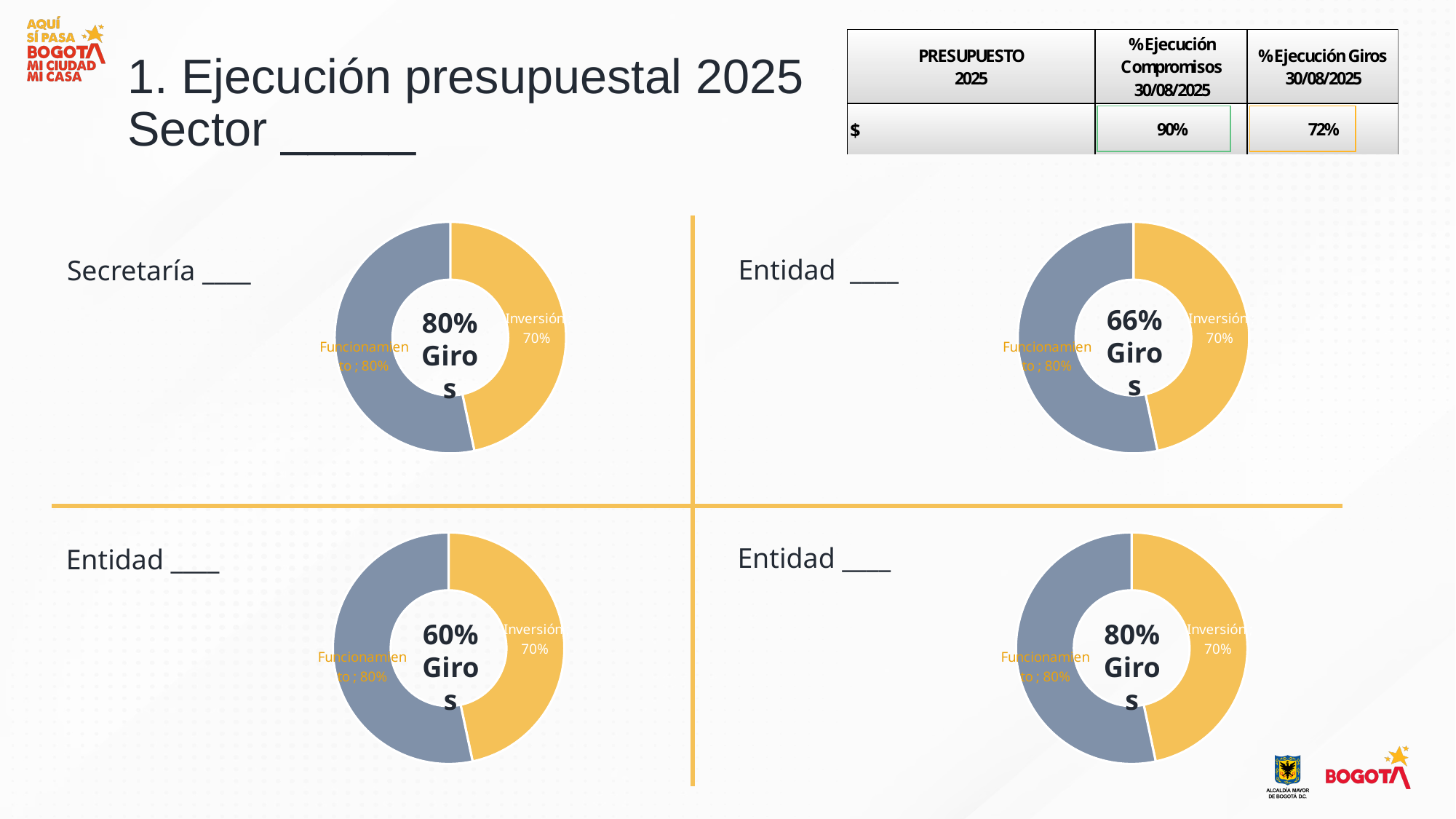
What kind of chart is used in each of the four quadrants of the slide? Donut (pie) chart What percentage of Giros is shown in the centre of the bottom-left donut chart? 60% Which of the four donut charts shows the lowest Giros percentage in its centre? Bottom-left (60% Giros) In the top-right donut chart, what is the difference between the Funcionamiento value and the Inversión value? 10% In the bottom-right donut chart, which category has the higher value, Inversión or Funcionamiento? Funcionamiento How many slices does the bottom-left donut chart have? 2 In the top-left donut chart, what colour is the Inversión slice? Yellow/orange What percentage of Giros is shown in the centre of the top-right donut chart? 66% In the top-left donut chart (Secretaría), what value is shown for Inversión? 70% In the top-left donut chart (Secretaría), what value is shown for Funcionamiento? 80% What percentage of Giros is shown in the centre of the bottom-right donut chart? 80% What percentage of Giros is shown in the centre of the top-left donut chart? 80%